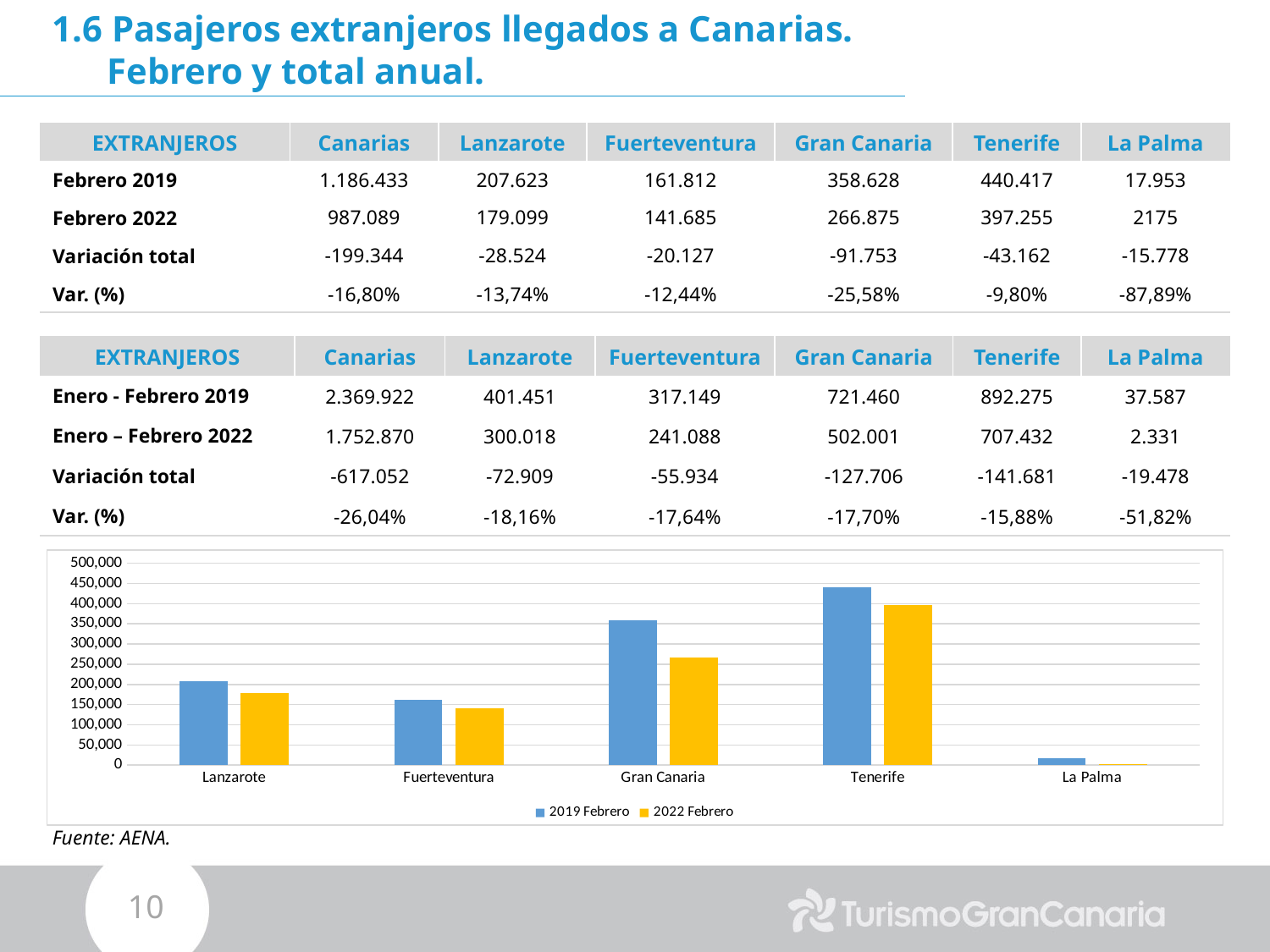
According to the slide, what is the Febrero 2022 value for Tenerife plotted in the chart? 397.255 Which island has the lowest 2022 Febrero bar in the chart? La Palma Which island has the highest 2019 Febrero bar in the chart? Tenerife How many islands are shown on the x axis of the chart? 5 In the chart, which is larger for Gran Canaria: the 2019 Febrero bar or the 2022 Febrero bar? 2019 Febrero According to the slide, what is the Febrero 2019 value for Gran Canaria plotted in the chart? 358.628 In the chart, is the 2022 Febrero value for Fuerteventura greater or less than 150,000? less What type of chart is shown at the bottom of the slide? bar chart Which colour represents the 2022 Febrero series in the chart? yellow In the chart, is the 2022 Febrero value for Gran Canaria greater or less than 250,000? greater In the chart, is the 2019 Febrero value for Tenerife greater or less than 400,000? greater How many series does the chart legend list? 2